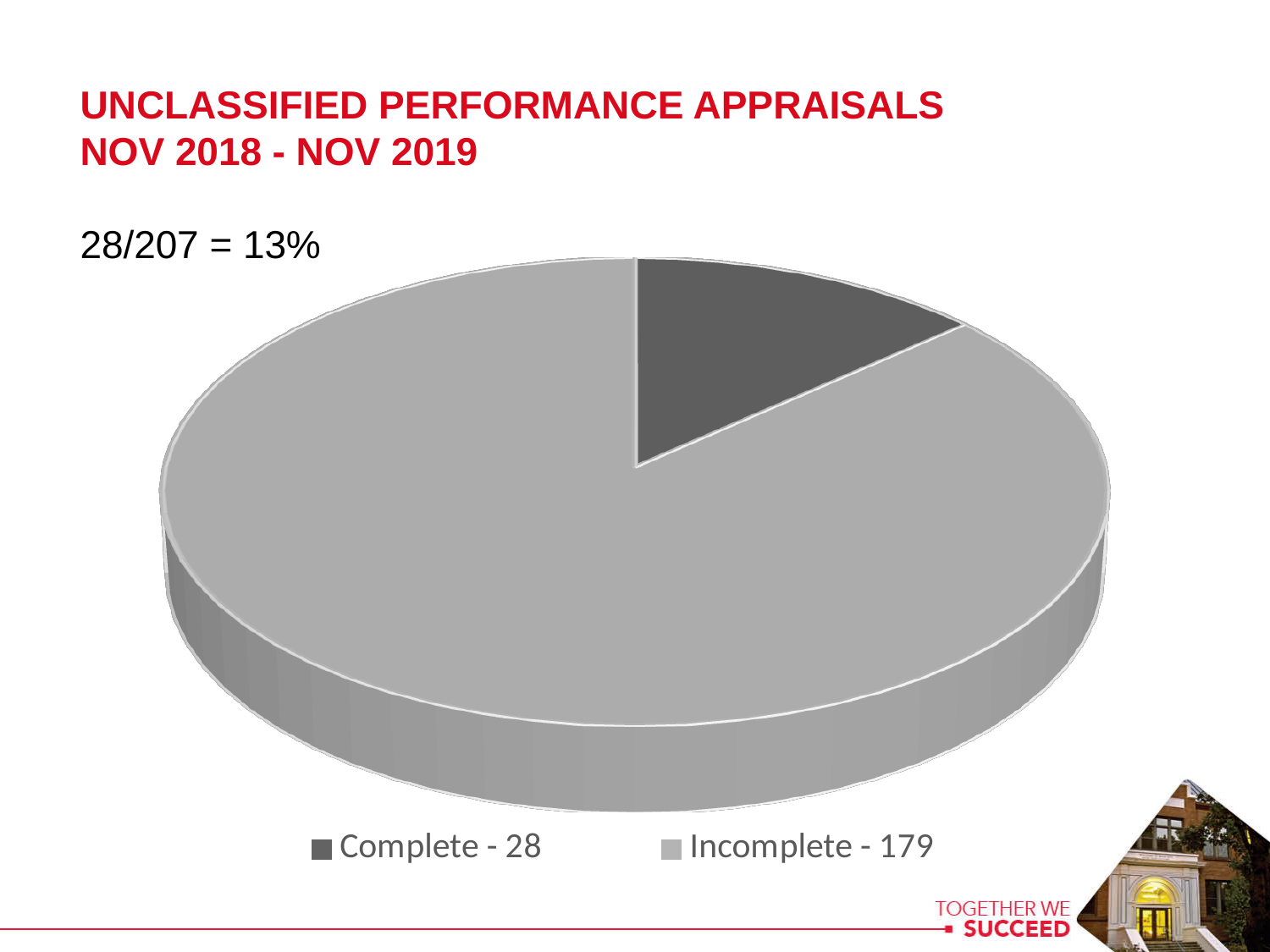
What is the value for Incomplete? 179 Which category has the smallest slice? Complete How many entries does the legend list? 2 What is the value for Complete? 28 Which category has the largest slice? Incomplete What is the total of the two slices in the pie chart? 207 Which is larger, Complete or Incomplete? Incomplete What is the difference between the Incomplete and Complete values? 151 How many slices does the pie chart have? 2 What share of the pie does the Complete slice represent, as printed on the slide? 13% What kind of chart is shown on the slide? pie chart What colour is the Complete slice? dark gray